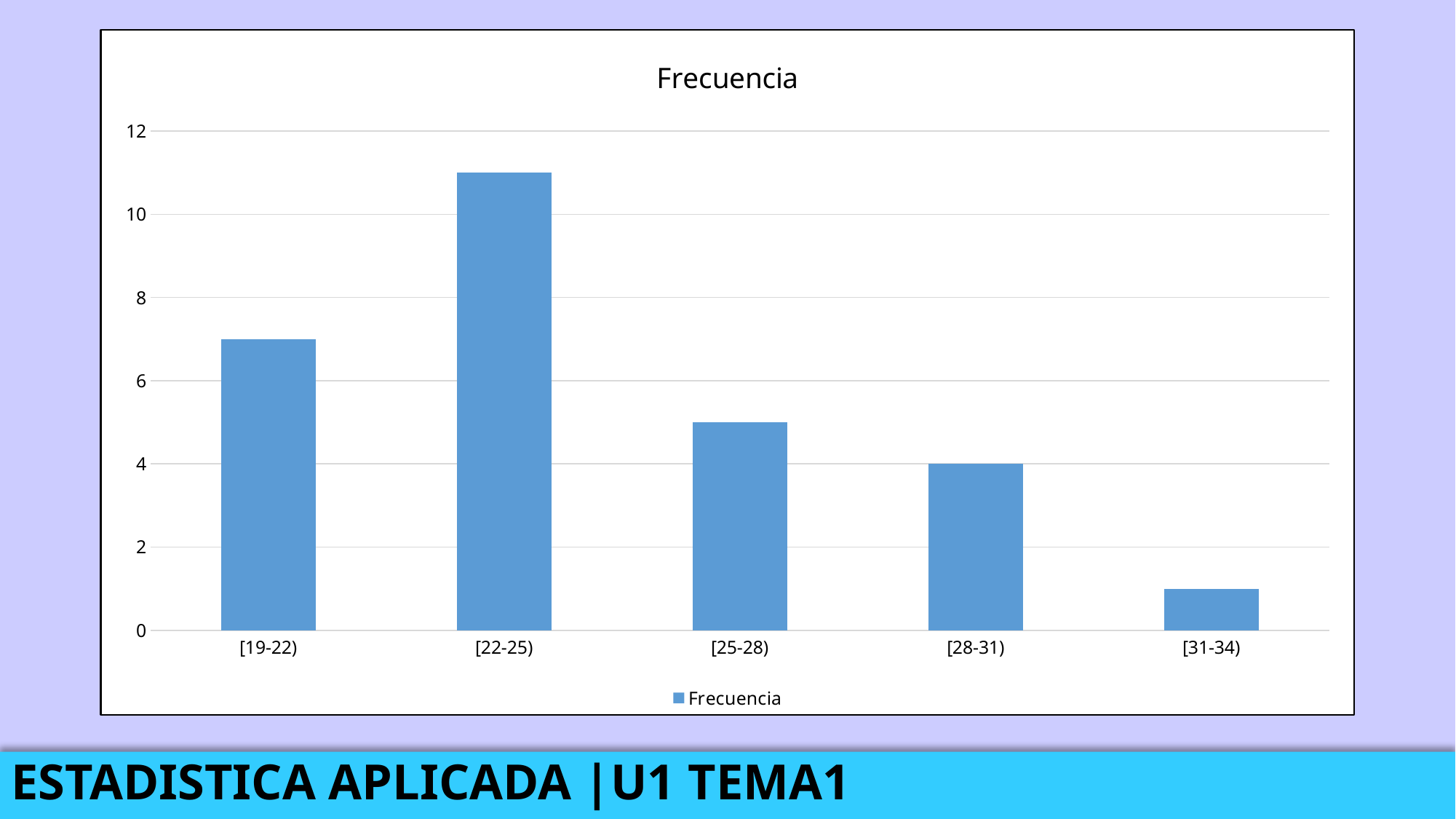
What is the title of the chart? Frecuencia Which category has the highest frequency? [22-25) What is the frequency for the category [28-31)? 4 What type of chart is shown on the slide? bar chart Is the value for [31-34) greater or less than 2? less Is the value for [19-22) greater or less than 6? greater Which is larger, the value for [19-22) or the value for [25-28)? [19-22) How many categories are shown on the x axis of the chart? 5 Which category has the lowest frequency? [31-34) How many series does the legend list? 1 Do the values rise or fall from [22-25) to [31-34) along the x axis? fall Is the value for [22-25) greater or less than 10? greater